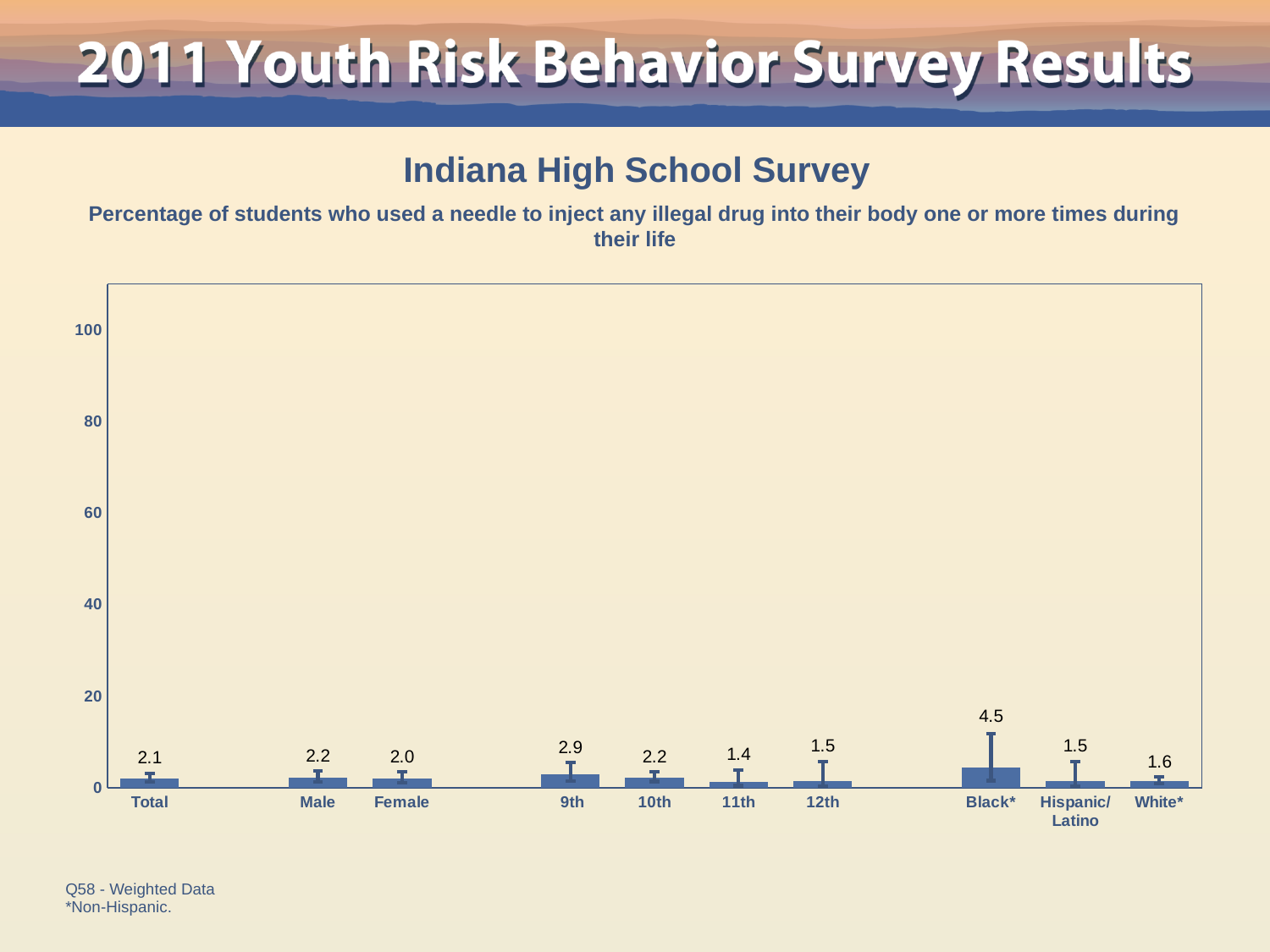
What kind of chart is this? bar chart What is the value for Hispanic/Latino? 1.5 What is the value for Total? 2.1 What is the value for Black*? 4.5 What is the value for 11th? 1.4 How many categories are shown on the x axis? 10 Which category has the highest value? Black* Which category has the lowest value? 11th What is the difference between the values for 9th and 12th? 1.4 Is the value for Black* greater or less than 20? less What is the difference between the values for Black* and White*? 2.9 Which is larger, the value for Male or the value for Female? Male